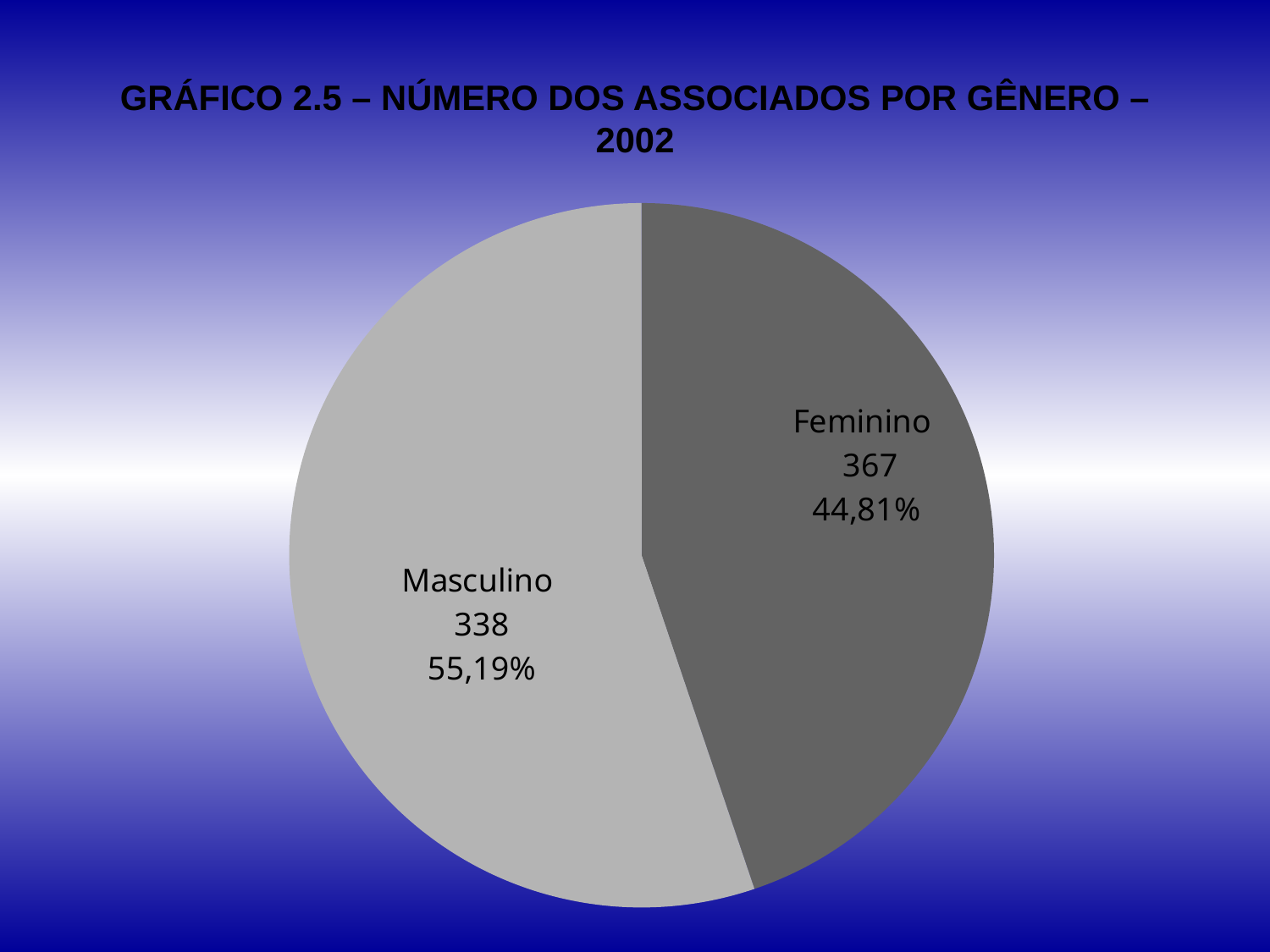
Which year does the chart title refer to? 2002 What kind of chart is shown on the slide? pie chart What is the sum of the numbers printed for the two slices? 705 What number is printed for the Feminino slice? 367 What is the title of the chart? GRÁFICO 2.5 – NÚMERO DOS ASSOCIADOS POR GÊNERO – 2002 How many slices does the pie chart have? 2 Which slice is labelled with the larger percentage share? Masculino What percentage share is printed for the Masculino slice? 55,19% What percentage share is printed for the Feminino slice? 44,81% Which slice is drawn in the darker grey colour? Feminino What is the difference between the numbers printed for Feminino and Masculino? 29 What number is printed for the Masculino slice? 338